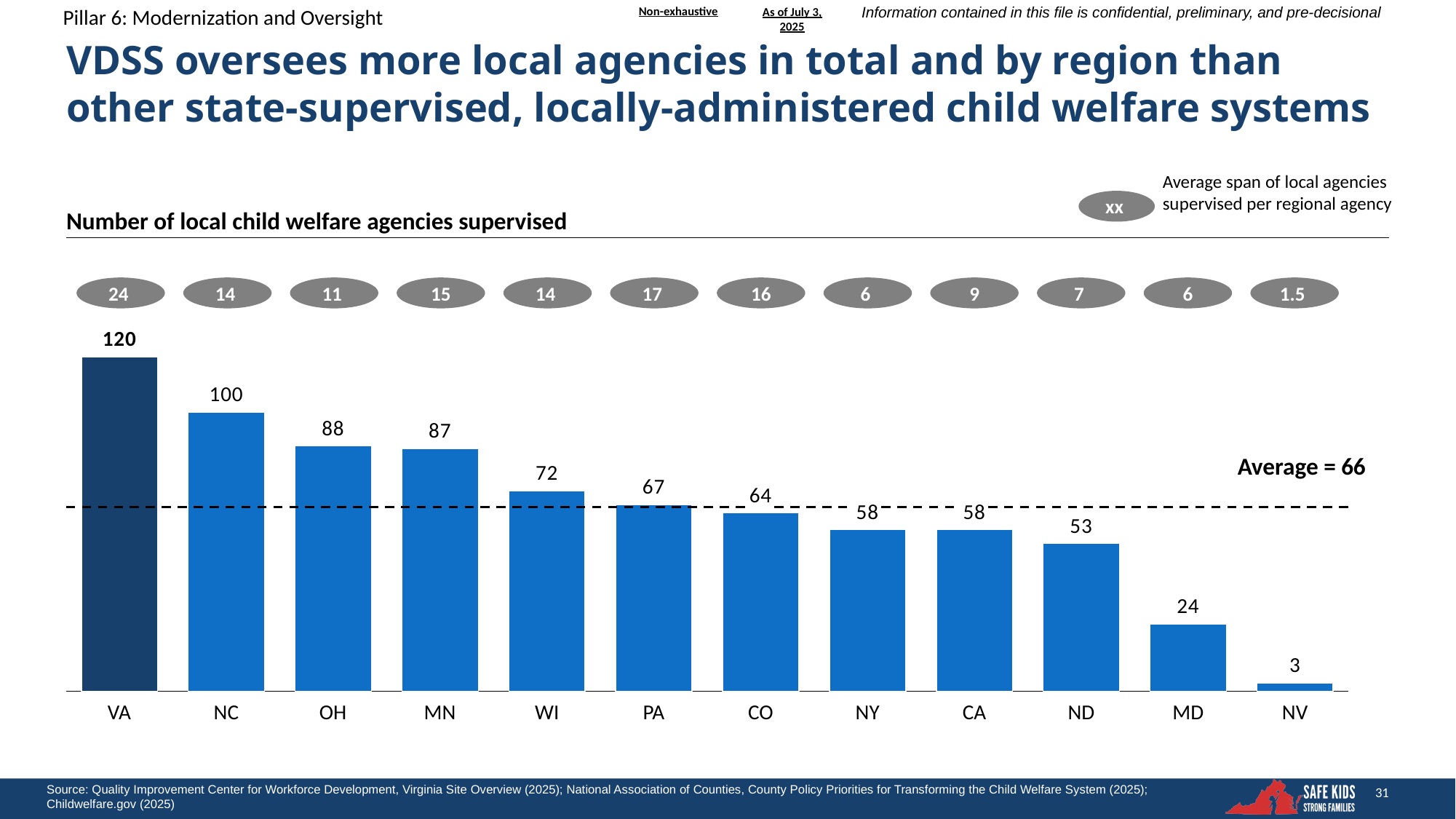
What is the number of local child welfare agencies supervised for MN? 87 What is the number of local child welfare agencies supervised for ND? 53 Which state has the highest number of local child welfare agencies supervised? VA What is the difference between the number of local agencies supervised in VA and NC? 20 What kind of chart is used to show the number of local child welfare agencies supervised? Bar chart Which state has the lowest number of local child welfare agencies supervised? NV Which has more local child welfare agencies supervised, WI or CO? WI What is the difference between the number of local agencies supervised in OH and MD? 64 What is the number of local child welfare agencies supervised for VA? 120 Do the values rise or fall moving from left to right along the x axis? Fall How many states are shown in the chart? 12 What is the average value marked by the dashed line on the chart? 66